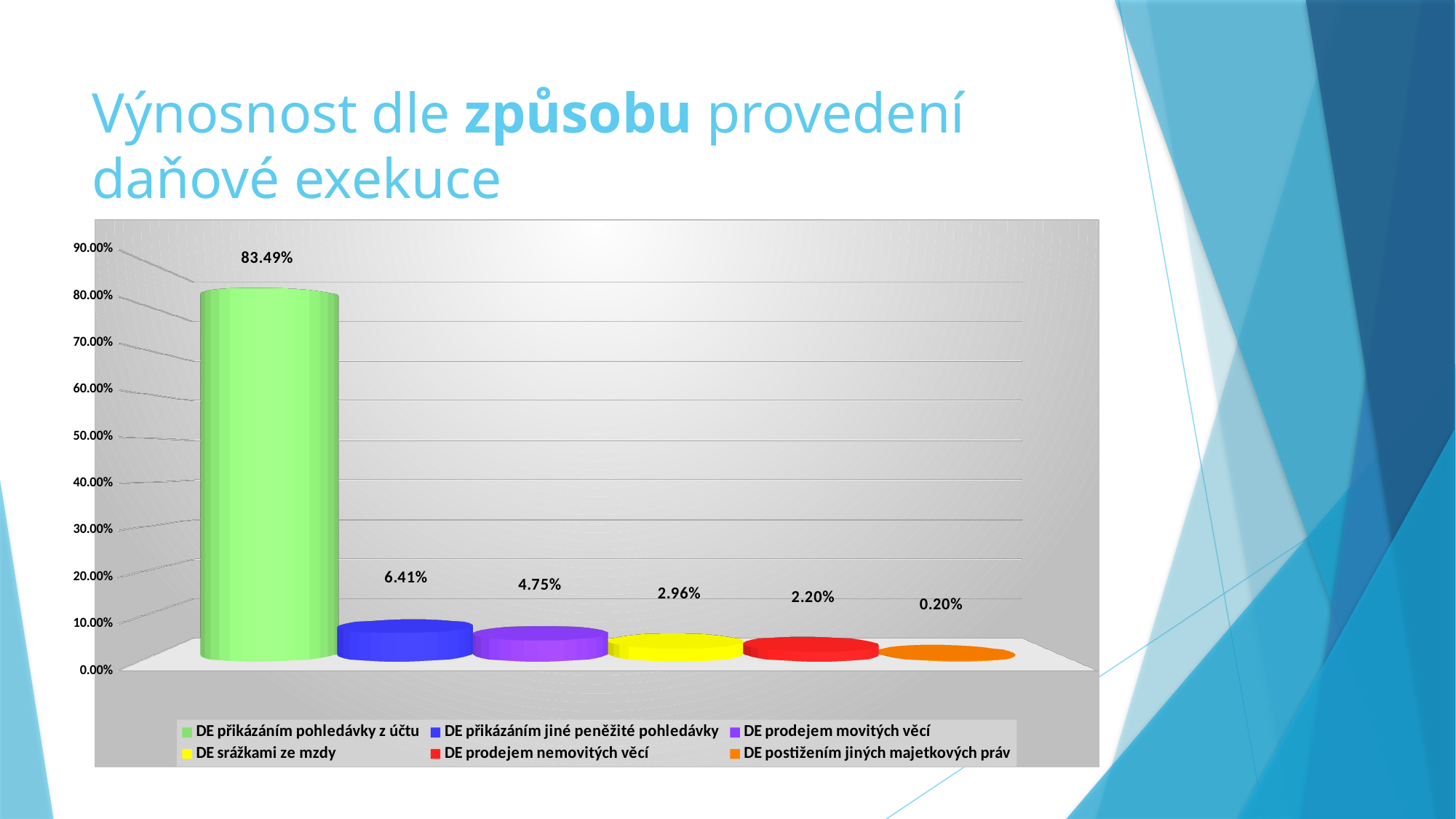
What is the value for DE přikázáním jiné peněžité pohledávky? 6.41% What is the value for DE postižením jiných majetkových práv? 0.20% What is the value for DE srážkami ze mzdy? 2.96% How many categories are shown in the chart? 6 Which category has the highest value? DE přikázáním pohledávky z účtu Which is larger, the value for DE srážkami ze mzdy or the value for DE prodejem nemovitých věcí? DE srážkami ze mzdy What is the value for DE prodejem nemovitých věcí? 2.20% Which category has the lowest value? DE postižením jiných majetkových práv What is the difference between the values for DE přikázáním jiné peněžité pohledávky and DE prodejem movitých věcí? 1.66% What is the value for DE přikázáním pohledávky z účtu? 83.49% What kind of chart is shown on the slide? bar chart What is the value for DE prodejem movitých věcí? 4.75%